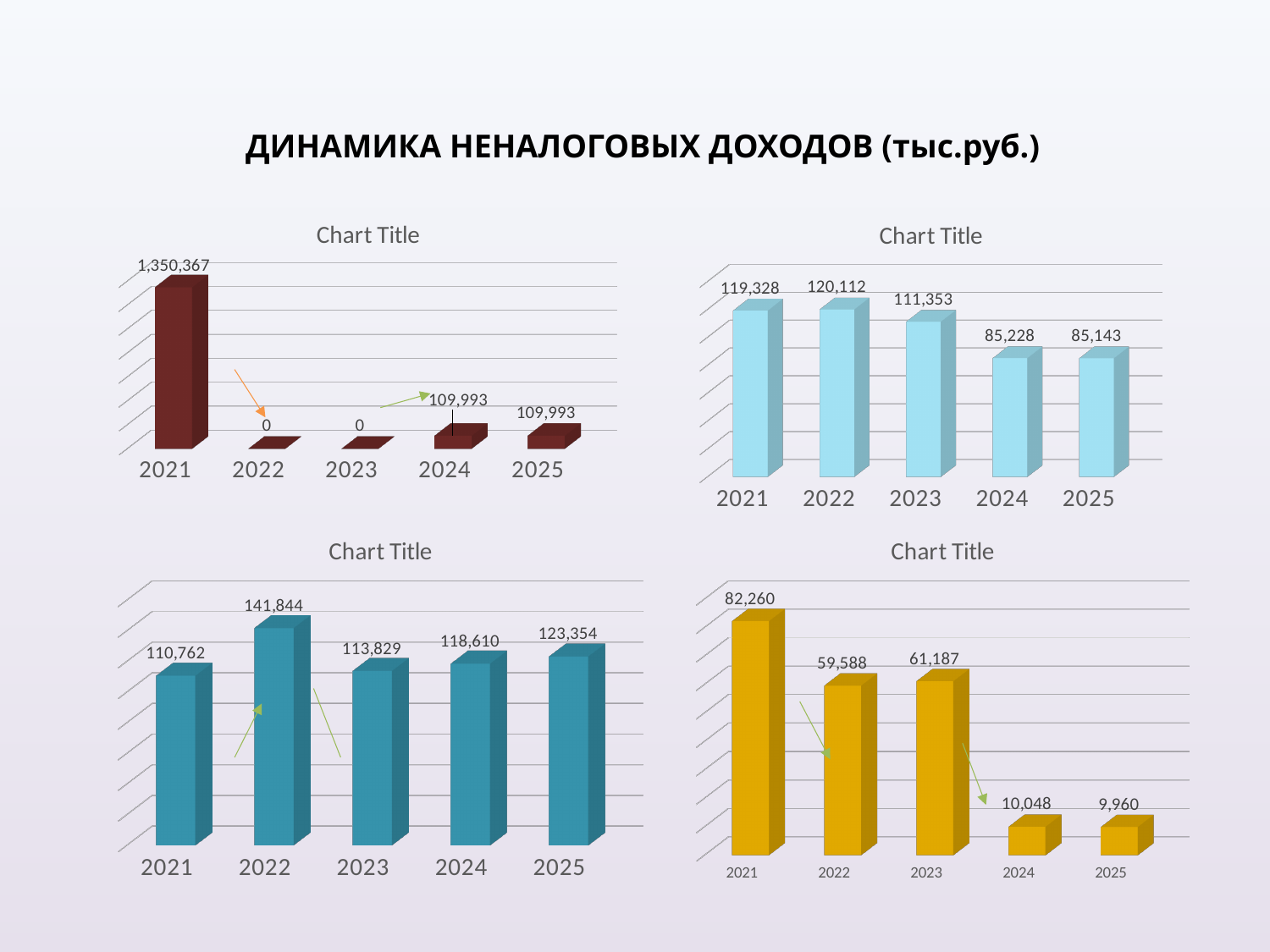
In the top-right chart, which year has the highest value? 2022 In the top-left chart, what is the value for 2024? 109,993 In the bottom-left chart, which is larger, the value for 2024 or the value for 2025? 2025 In the bottom-left chart, which year has the lowest value? 2021 In the bottom-right chart, what is the value for 2025? 9,960 In the top-left chart, what is the value for 2021? 1,350,367 In the top-right chart, what is the value for 2023? 111,353 In the bottom-left chart, what is the value for 2022? 141,844 In the top-right chart, what is the difference between the values for 2021 and 2024? 34,100 How many years are shown on the x axis of the bottom-right chart? 5 What kind of chart is the top-right chart? Bar chart In the bottom-right chart, what is the difference between the values for 2021 and 2022? 22,672